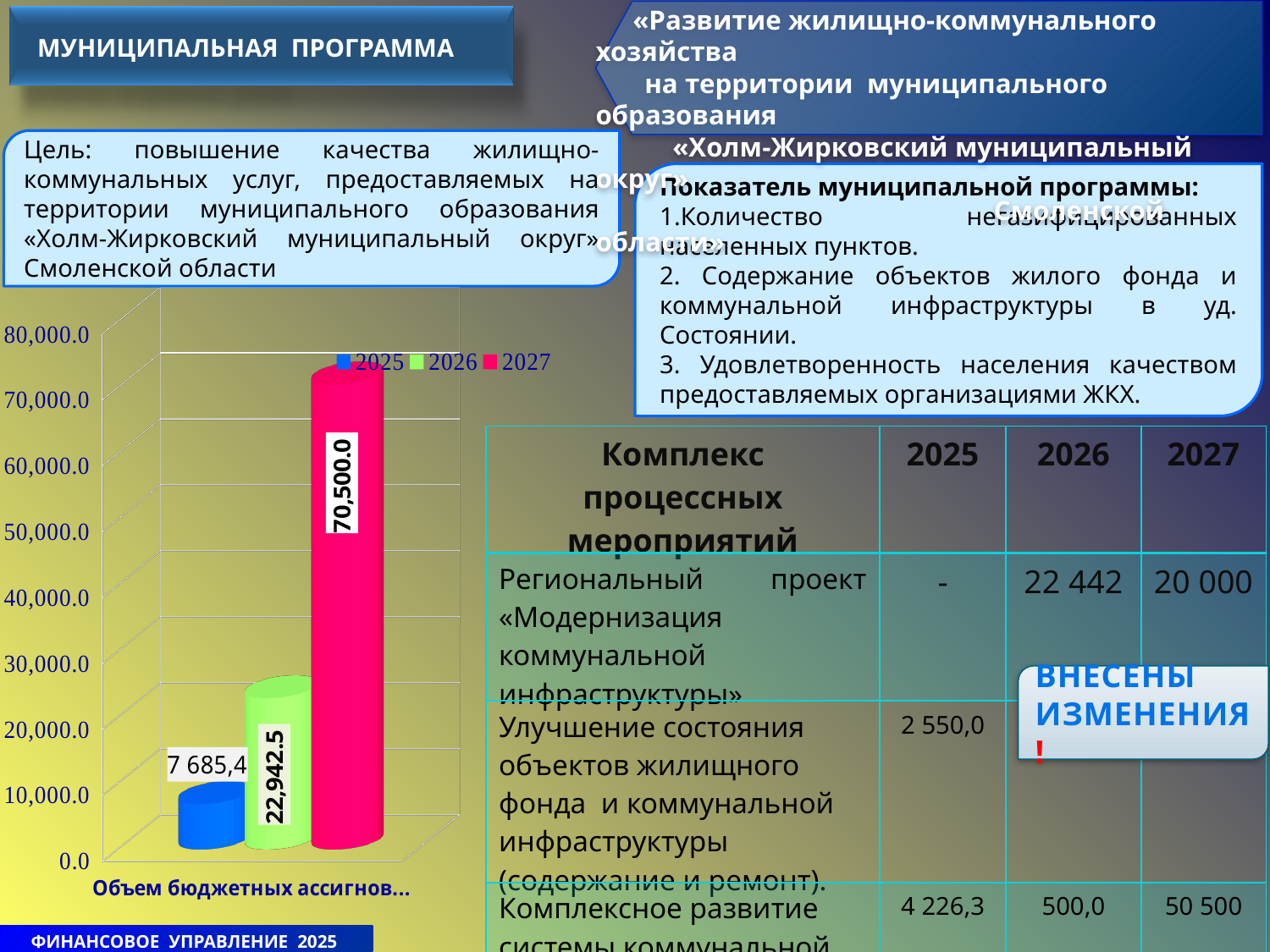
How many series does the chart legend list? 3 Do the values in the chart rise or fall from 2025 to 2027? rise What is the difference between the 2027 and 2026 values in the chart? 47,557.5 Which year has the highest value in the chart? 2027 What is the value of the 2025 bar in the chart? 7 685,4 What is the value of the 2026 bar in the chart? 22,942.5 What is the difference between the 2026 and 2025 values in the chart? 15,257.1 Which is larger in the chart, the 2026 value or the 2025 value? 2026 What kind of chart is shown on the slide? bar chart Is the value for 2027 greater or less than 60,000.0? greater What is the value of the 2027 bar in the chart? 70,500.0 Which year has the lowest value in the chart? 2025